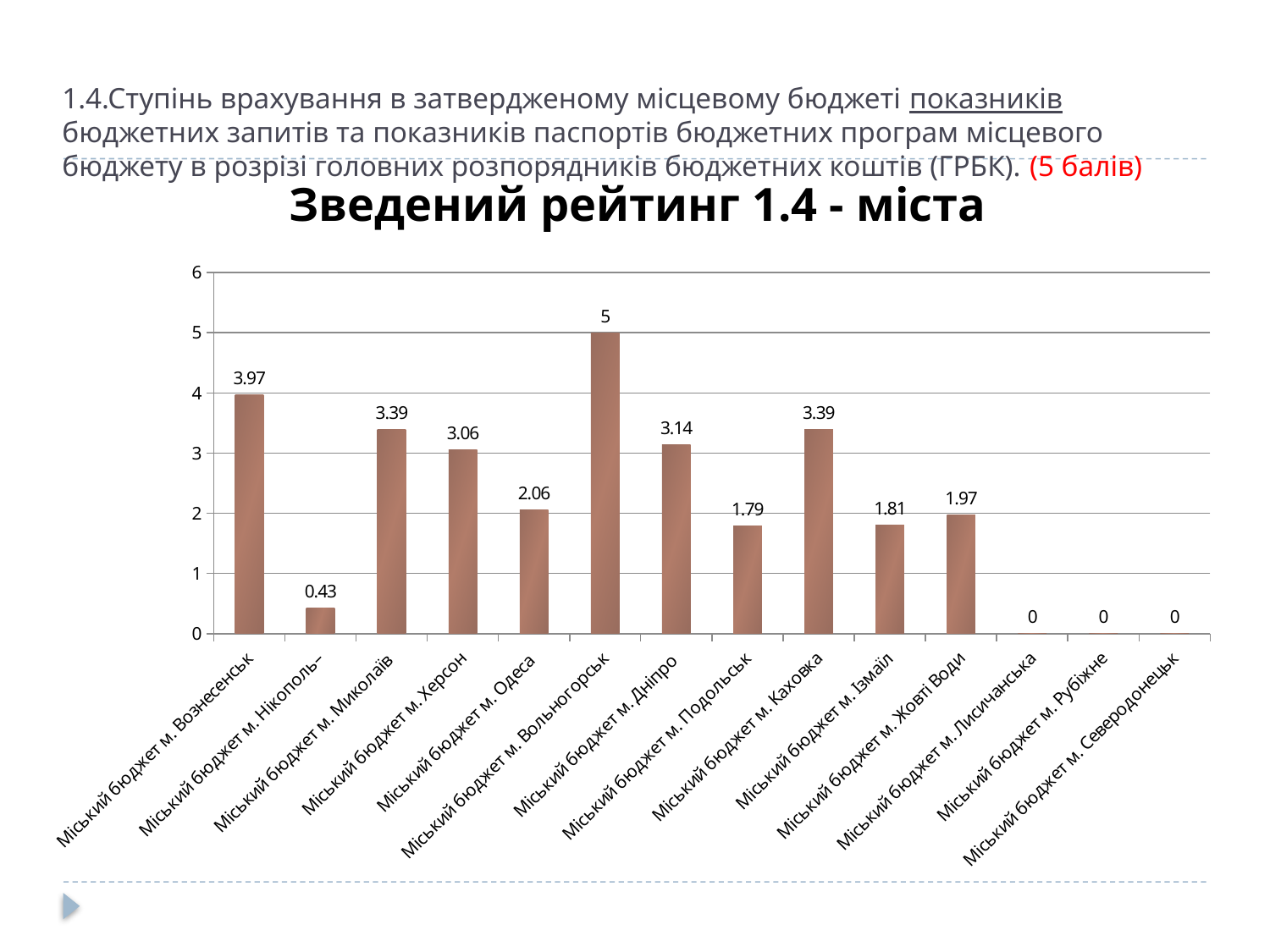
What is the value for Міський бюджет м. Подольськ? 1.79 What is the value for Міський бюджет м. Одеса? 2.06 What is the difference between the values for Міський бюджет м. Вольногорськ and Міський бюджет м. Вознесенськ? 1.03 How many city budgets are shown on the x axis? 14 What is the value for Міський бюджет м. Нікополь? 0.43 Which is larger, the value for Міський бюджет м. Херсон or for Міський бюджет м. Дніпро? Міський бюджет м. Дніпро How many city budgets have a value of 0? 3 Which city budget has the highest value in the chart? Міський бюджет м. Вольногорськ What is the title of the chart? Зведений рейтинг 1.4 - міста What type of chart is shown on the slide? Bar chart What is the value for Міський бюджет м. Вознесенськ? 3.97 What is the difference between the values for Міський бюджет м. Миколаїв and Міський бюджет м. Ізмаїл? 1.58